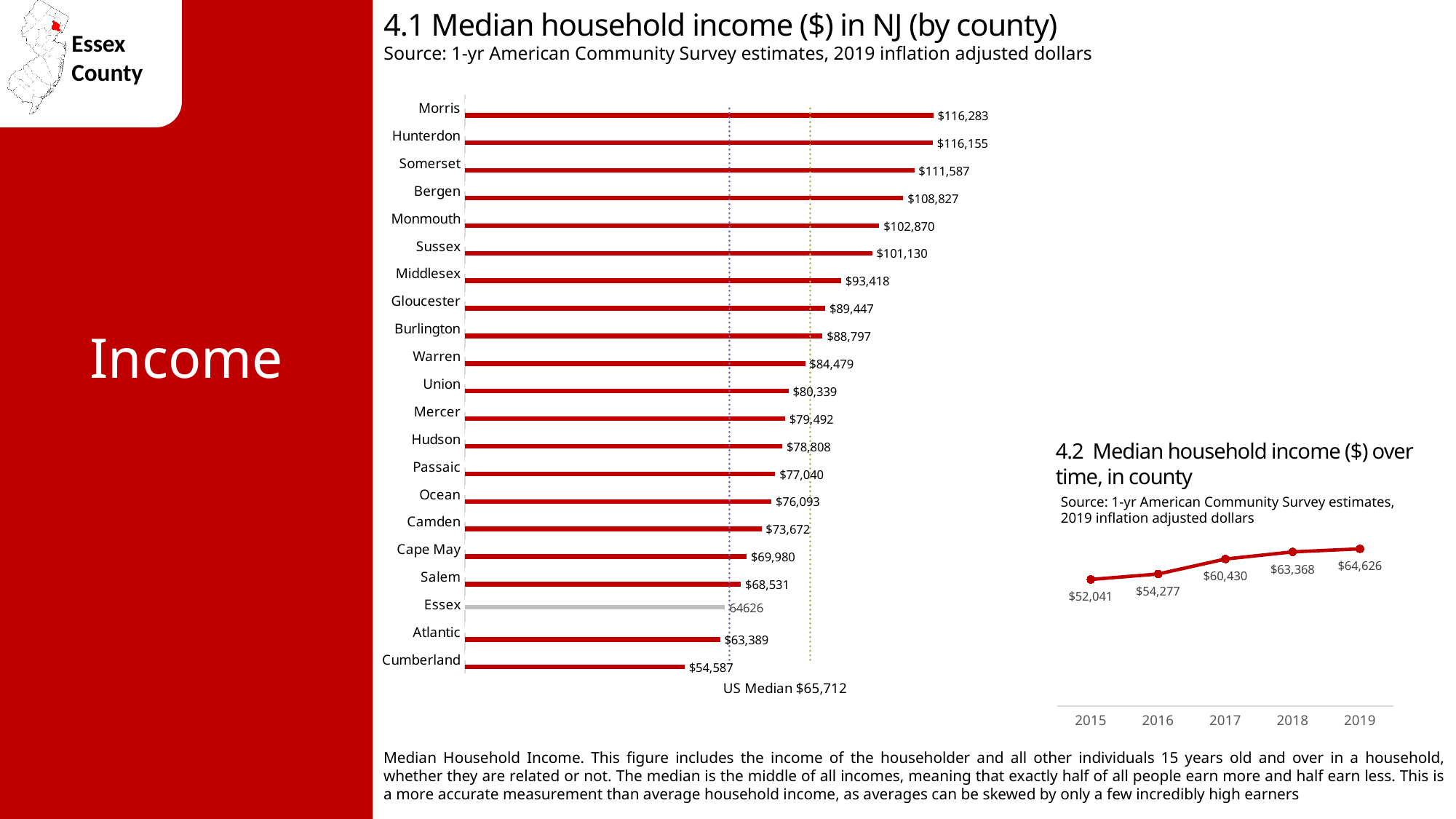
In chart 4.1, what value is shown for Essex county? 64626 In chart 4.1, which county has the lowest median household income? Cumberland In chart 4.1, what US Median value is labelled on the chart? $65,712 In chart 4.2, does the median household income rise or fall from 2015 to 2019? Rise In chart 4.1 (Median household income in NJ by county), what is the median household income for Bergen county? $108,827 In chart 4.2, what is the difference between the 2019 and 2015 median household income values? $12,585 What type of chart is chart 4.1? Bar chart How many counties are shown in chart 4.1? 21 In chart 4.1, which county has the highest median household income? Morris In chart 4.1, which county has a higher median household income, Hudson or Passaic? Hudson In chart 4.2 (Median household income over time, in county), what is the median household income in 2017? $60,430 In chart 4.1, what is the difference between the median household income of Morris and Cumberland counties? $61,696